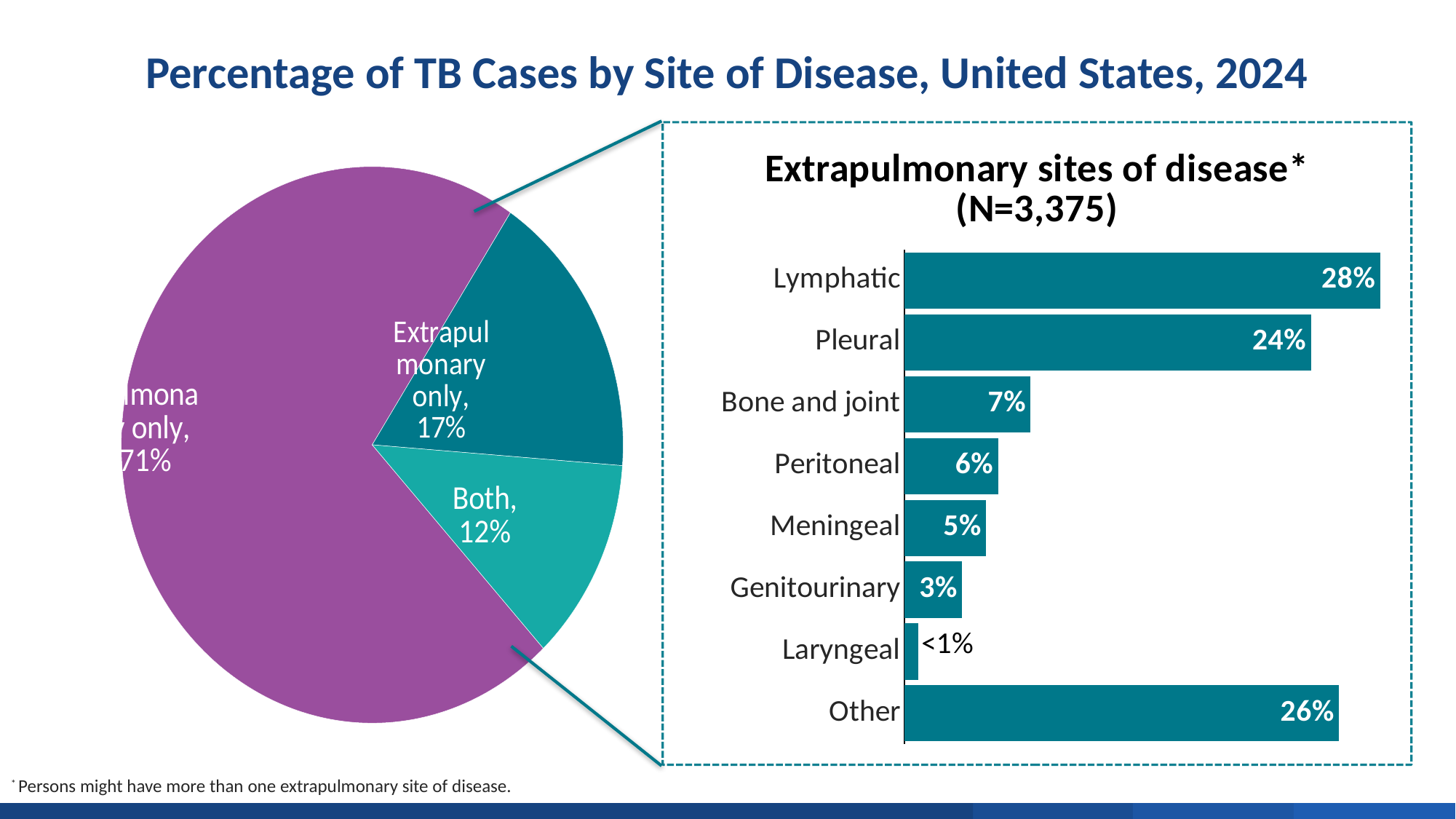
What is the N value given in the title of the 'Extrapulmonary sites of disease' chart? 3,375 How many sites are listed in the 'Extrapulmonary sites of disease' bar chart? 8 In the 'Extrapulmonary sites of disease' chart, what is the value for Lymphatic? 28% In the 'Extrapulmonary sites of disease' chart, which site has the highest value? Lymphatic In the 'Extrapulmonary sites of disease' chart, what is the difference between the values for Lymphatic and Pleural? 4% In the pie chart on the left, what percentage is shown for 'Both'? 12% In the pie chart on the left, what percentage is shown for 'Extrapulmonary only'? 17% In the 'Extrapulmonary sites of disease' chart, what is the value for Pleural? 24% In the 'Extrapulmonary sites of disease' chart, which is larger, the value for Other or the value for Pleural? Other What kind of chart is shown on the right side of the slide, under the title 'Extrapulmonary sites of disease'? bar chart What kind of chart is shown on the left side of the slide? pie chart In the 'Extrapulmonary sites of disease' chart, which site has the lowest value? Laryngeal